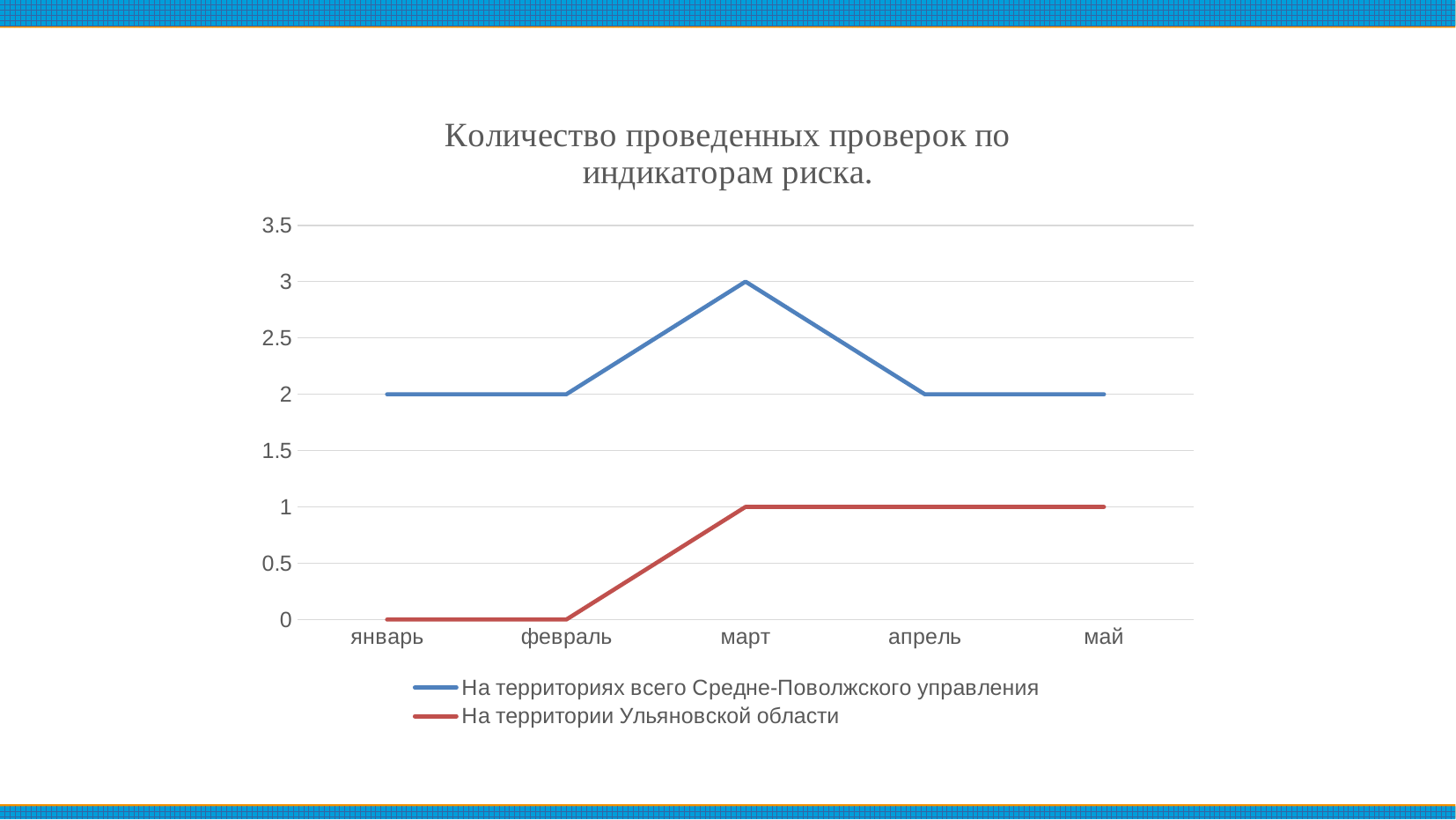
What colour is the line for 'На территории Ульяновской области'? red What kind of chart is shown on the slide? line chart In which month does the series 'На территориях всего Средне-Поволжского управления' reach its highest value? март What is the value for январь for the series 'На территории Ульяновской области'? 0 What is the value for май for the series 'На территории Ульяновской области'? 1 What is the value for март for the series 'На территориях всего Средне-Поволжского управления'? 3 How many months are shown on the x axis? 5 What is the title of the chart? Количество проведенных проверок по индикаторам риска. How many series does the legend list? 2 Does the series 'На территории Ульяновской области' rise or fall between февраль and март? rise Which series has the larger value in апрель? На территориях всего Средне-Поволжского управления What is the difference between the two series in март? 2